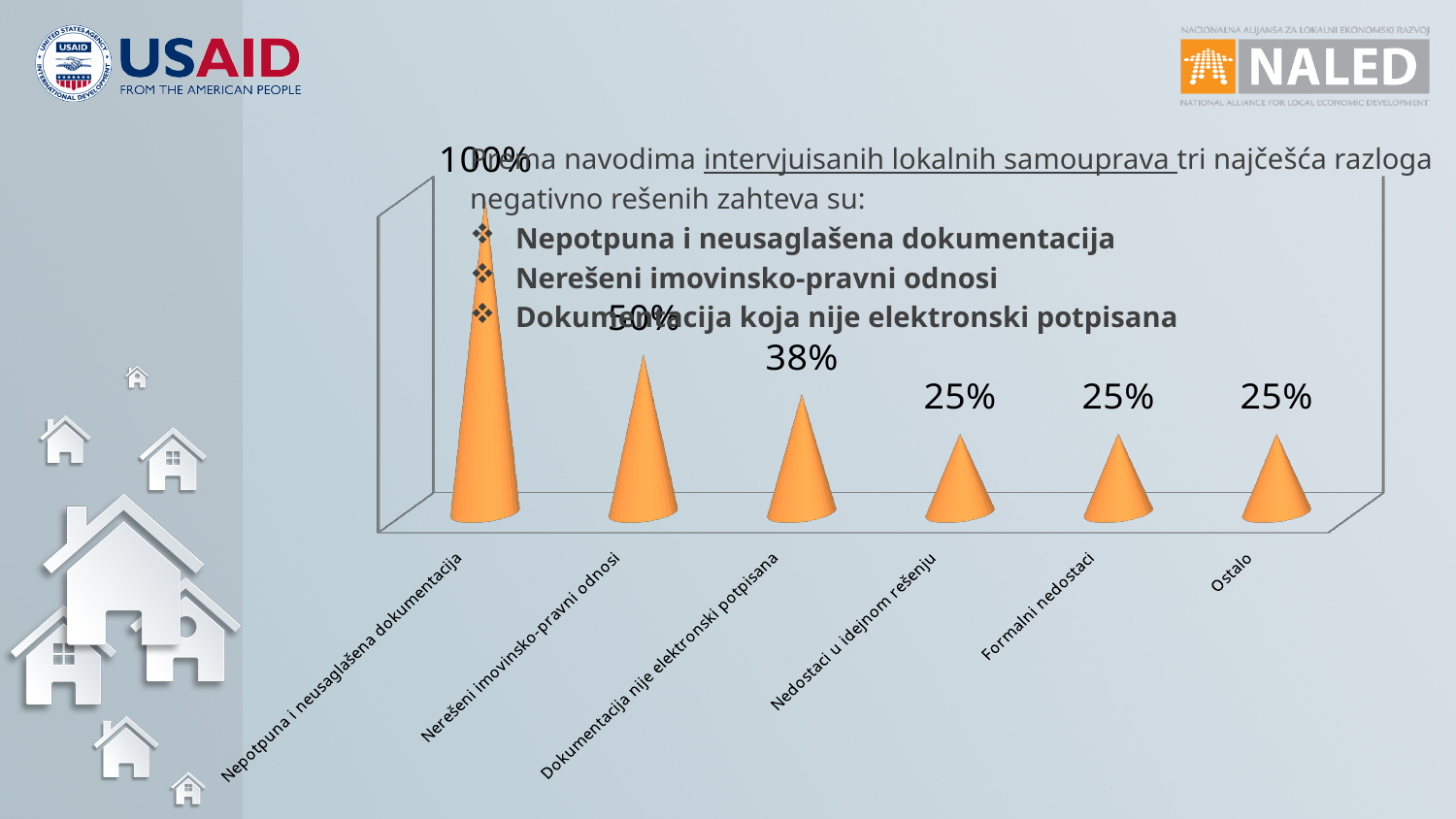
What is the difference between the values for Nepotpuna i neusaglašena dokumentacija and Nerešeni imovinsko-pravni odnosi? 50% What kind of chart is shown on the slide? Bar chart Which category has the highest value? Nepotpuna i neusaglašena dokumentacija What is the value for Nepotpuna i neusaglašena dokumentacija? 100% Do the values rise or fall from left to right along the x axis? Fall Which is larger, the value for Nerešeni imovinsko-pravni odnosi or the value for Dokumentacija nije elektronski potpisana? Nerešeni imovinsko-pravni odnosi What is the value for Ostalo? 25% What is the difference between the values for Dokumentacija nije elektronski potpisana and Nedostaci u idejnom rešenju? 13% What is the value for Dokumentacija nije elektronski potpisana? 38% How many categories are shown on the chart? 6 What is the value for Nerešeni imovinsko-pravni odnosi? 50% What is the value for Formalni nedostaci? 25%